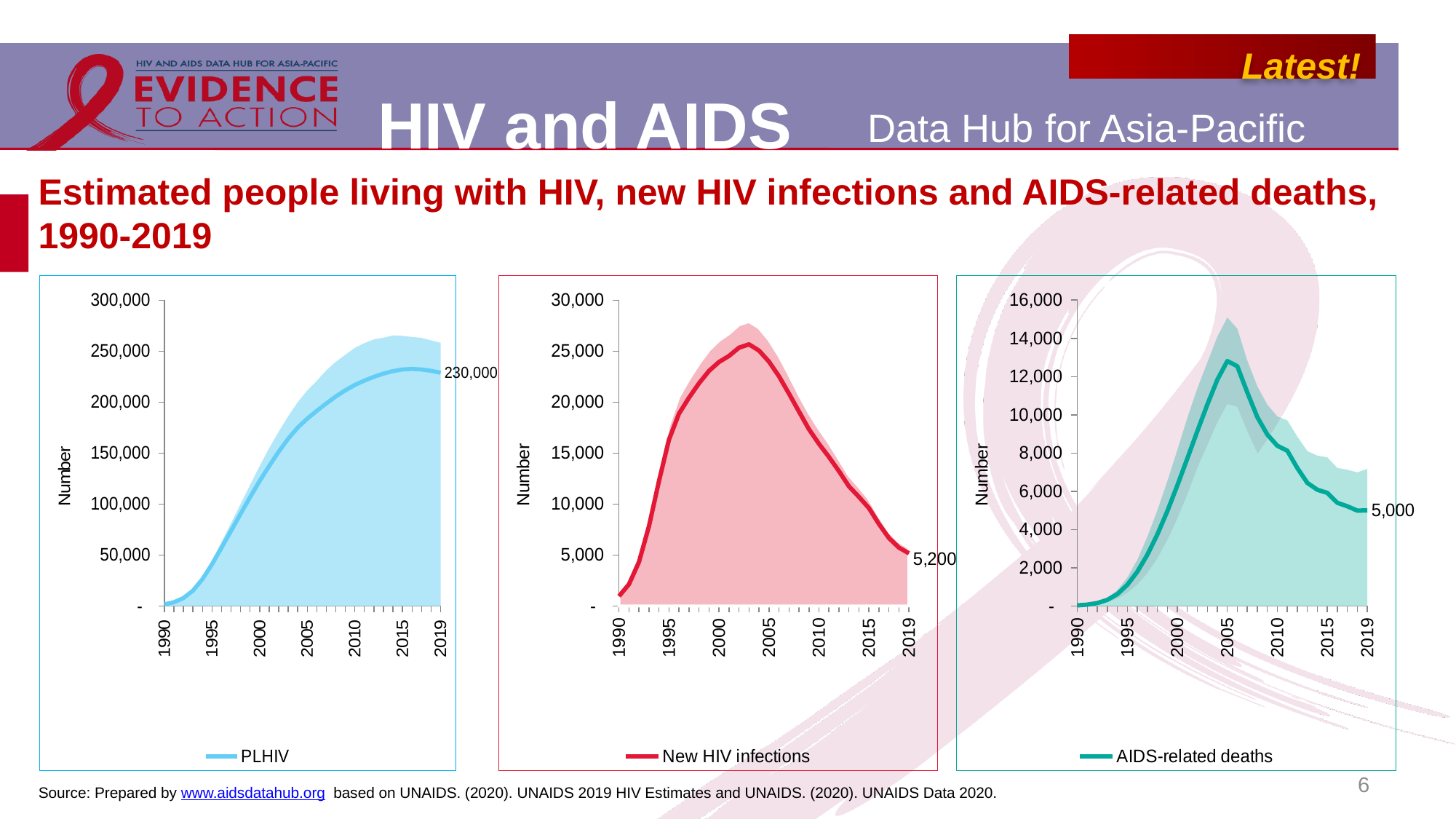
In the left chart (PLHIV), do the values rise or fall from 1990 to 2010? rise How many series does the legend of the right chart list? 1 What kind of chart is the left chart (PLHIV)? combination area and line chart (a line with a shaded area band) In the middle chart (New HIV infections), do the values rise or fall from 2005 to 2019? fall In the middle chart (New HIV infections), what is the value labelled for 2019? 5,200 In the left chart (PLHIV), is the value for 2000 greater or less than 100,000? greater In the left chart (PLHIV), what is the value labelled for 2019? 230,000 Which is larger: the 2019 value in the middle chart (New HIV infections) or the 2019 value in the right chart (AIDS-related deaths)? New HIV infections (5,200) In the right chart (AIDS-related deaths), what is the value labelled for 2019? 5,000 In the right chart (AIDS-related deaths), is the value for 2005 greater or less than 10,000? greater What is the legend entry of the middle chart? New HIV infections In the middle chart (New HIV infections), is the value for 2019 greater or less than 10,000? less